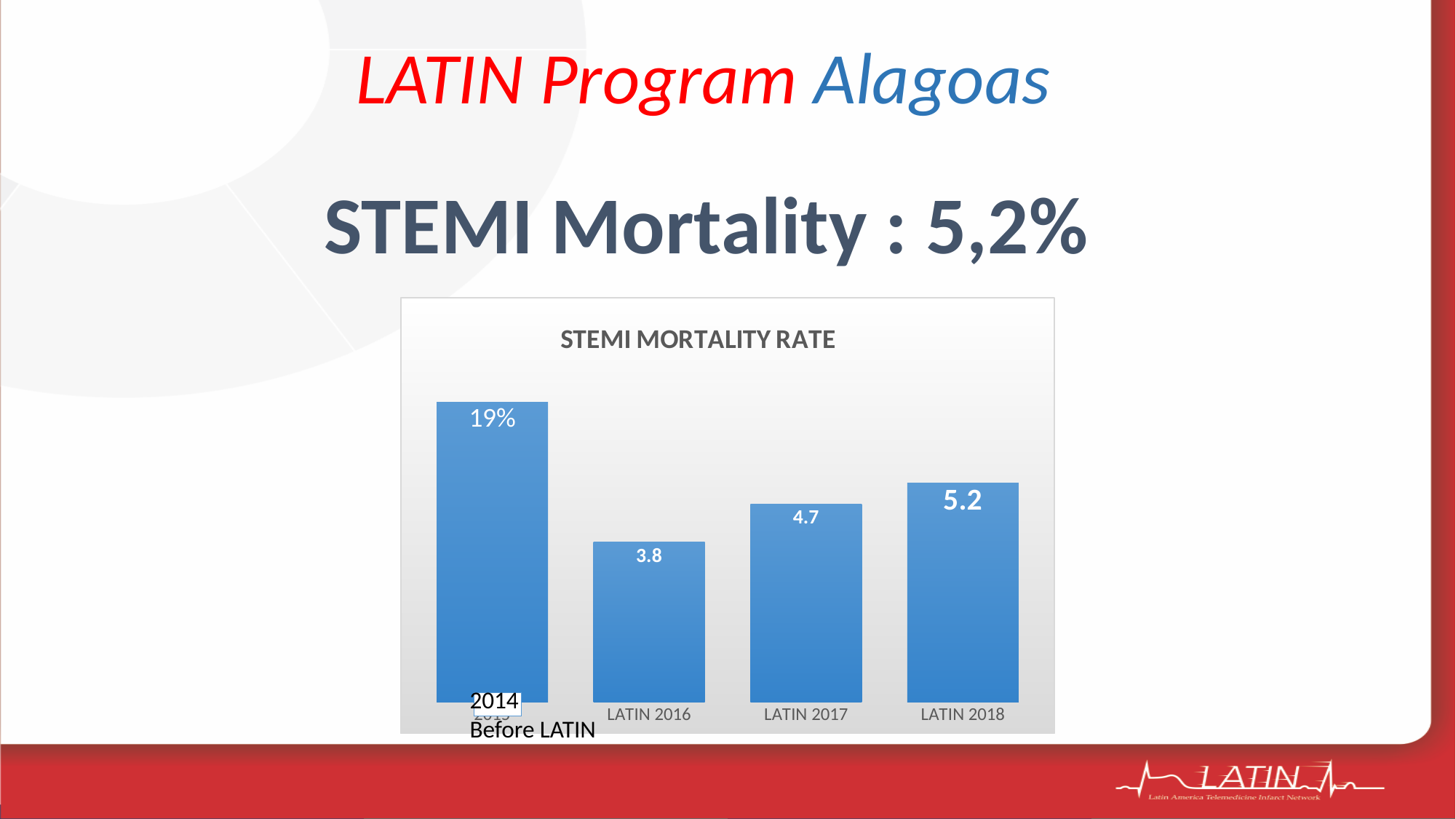
What is the difference between the values for LATIN 2018 and LATIN 2016? 1.4 What is the value shown for the 2014 Before LATIN bar? 19% What is the value shown for LATIN 2017? 4.7 Which category has the highest STEMI mortality rate? 2014 Before LATIN What type of chart is shown on the slide? bar chart How many bars does the STEMI MORTALITY RATE chart have? 4 Which is larger, the value for LATIN 2017 or the value for LATIN 2018? LATIN 2018 What is the value shown for LATIN 2016? 3.8 Which category has the lowest STEMI mortality rate? LATIN 2016 Do the values rise or fall from LATIN 2016 to LATIN 2018? rise What is the title of the chart? STEMI MORTALITY RATE What is the value shown for LATIN 2018? 5.2